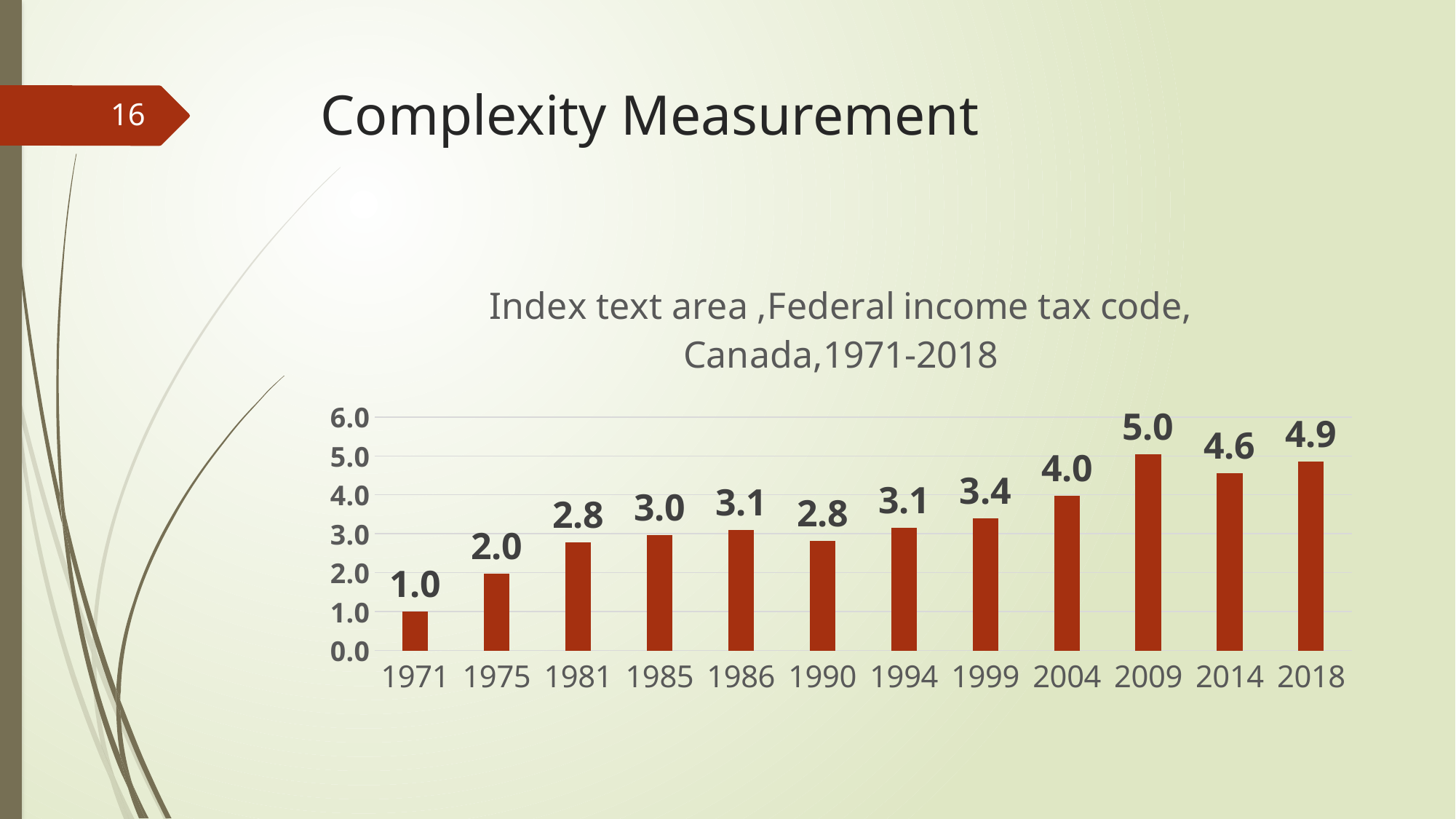
What is the index value for 2009? 5.0 What kind of chart is shown on the slide? Bar chart Which year has the lowest index value? 1971 What is the index value for 1971? 1.0 Is the index value for 2004 greater or less than 3.0? greater What is the index value for 1999? 3.4 What is the difference between the index values for 2018 and 1971? 3.9 Which year has the highest index value? 2009 How many years are shown on the x axis? 12 Does the index value generally rise or fall from 1971 to 2018? Rise Which is larger, the index value for 2014 or for 2018? 2018 What is the title of the chart? Index text area ,Federal income tax code, Canada,1971-2018